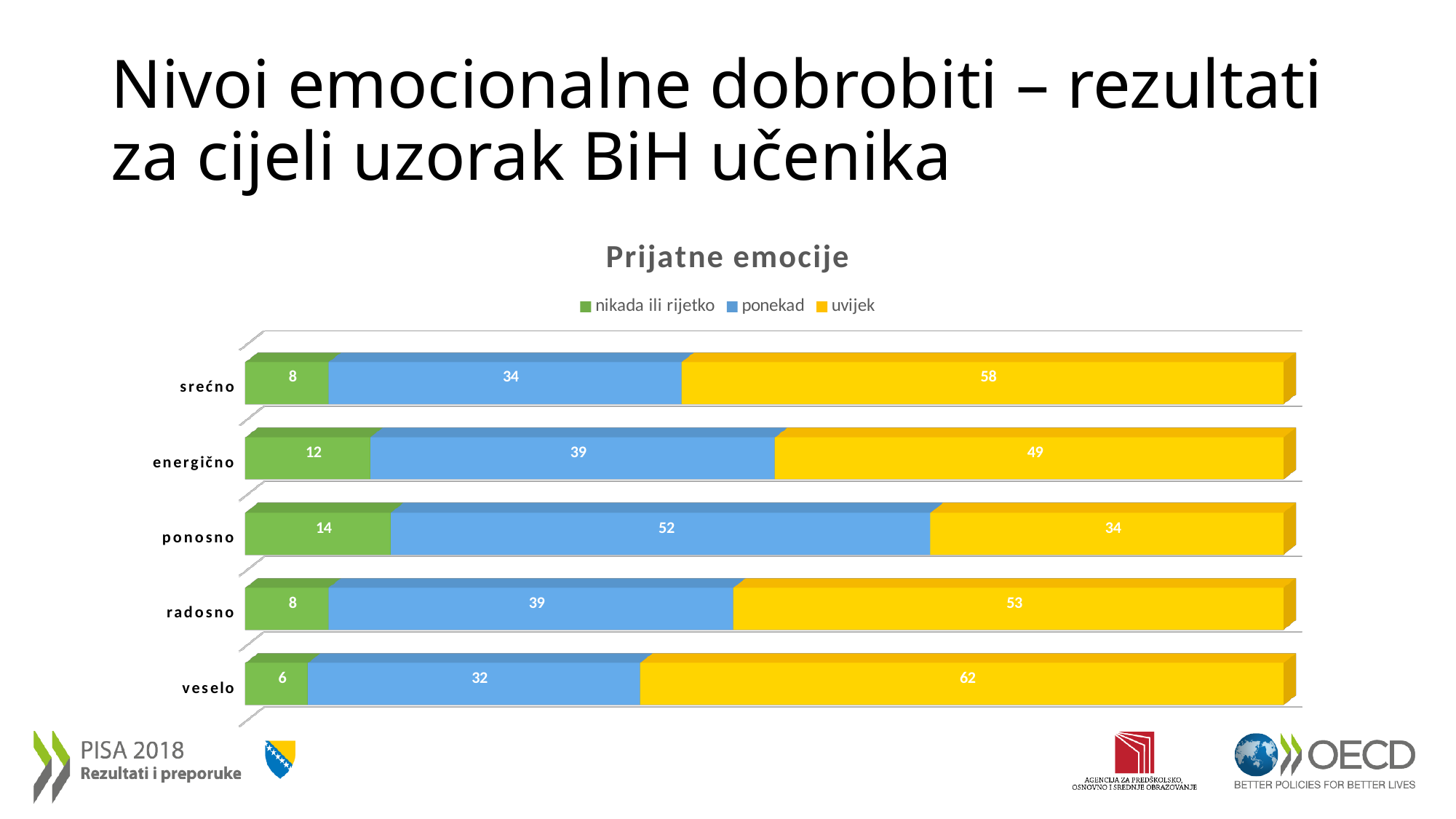
What is the value of 'nikada ili rijetko' for 'energično'? 12 What is the total of the stacked bar for 'radosno'? 100 How many series does the chart legend list? 3 What is the title of the chart? Prijatne emocije Which category has the highest 'uvijek' value? veselo What is the difference between the 'uvijek' values for 'srećno' and 'ponosno'? 24 Which is larger: the 'ponekad' value for 'energično' or for 'veselo'? energično Which category has the lowest 'nikada ili rijetko' value? veselo What is the value of 'uvijek' for 'veselo'? 62 What is the value of 'ponekad' for 'ponosno'? 52 How many categories are shown on the chart? 5 What kind of chart is shown on the slide? Stacked bar chart